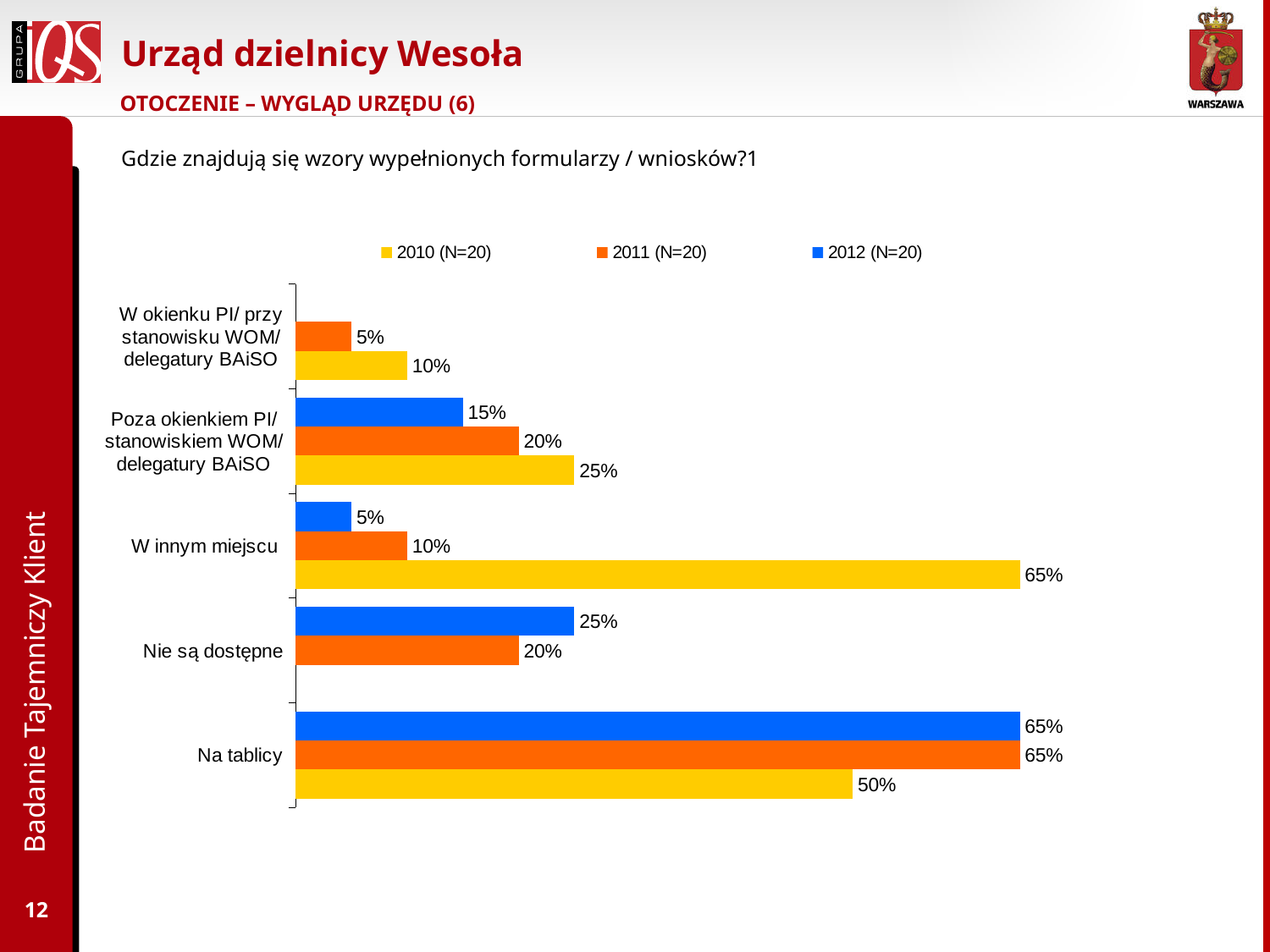
What is the value for 2012 (N=20) in the "Nie są dostępne" category? 25% How many series does the legend list? 3 What is the difference between the 2010 (N=20) and 2011 (N=20) values for "W innym miejscu"? 55% What is the value for 2010 (N=20) in the "Na tablicy" category? 50% What is the value for 2012 (N=20) in the "Poza okienkiem PI/ stanowiskiem WOM/ delegatury BAiSO" category? 15% Which colour represents the 2011 (N=20) series? Orange What is the value for 2011 (N=20) in the "W innym miejscu" category? 10% Which category has the highest value for the 2010 (N=20) series? W innym miejscu Which category has the lowest value for the 2012 (N=20) series? W innym miejscu Which is larger for "Nie są dostępne": the 2012 (N=20) value or the 2011 (N=20) value? 2012 (N=20) How many categories are shown on the chart? 5 What kind of chart is shown on the slide? Bar chart